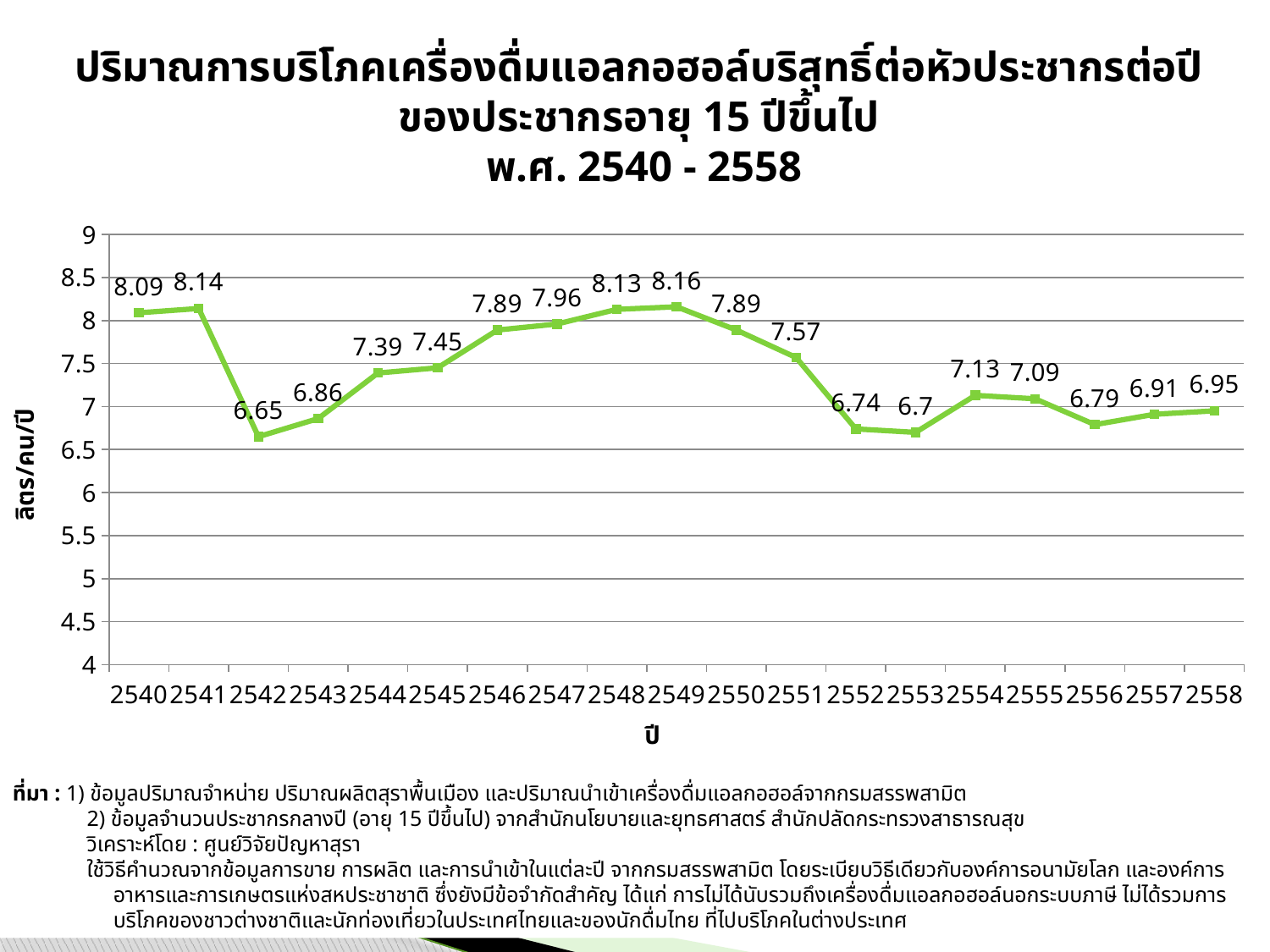
What is the value for the year 2542? 6.65 Which year has the lowest value? 2542 What is the value for the year 2553? 6.7 Which year has the larger value, 2544 or 2551? 2551 Do the values rise or fall from 2549 to 2553? fall What is the label of the vertical axis? ลิตร/คน/ปี What is the value for the year 2549? 8.16 Which year has the highest value? 2549 Is the value for 2556 greater or less than 7? less How many years are plotted on the chart? 19 What kind of chart is shown on the slide? line chart What is the difference between the values for 2541 and 2542? 1.49